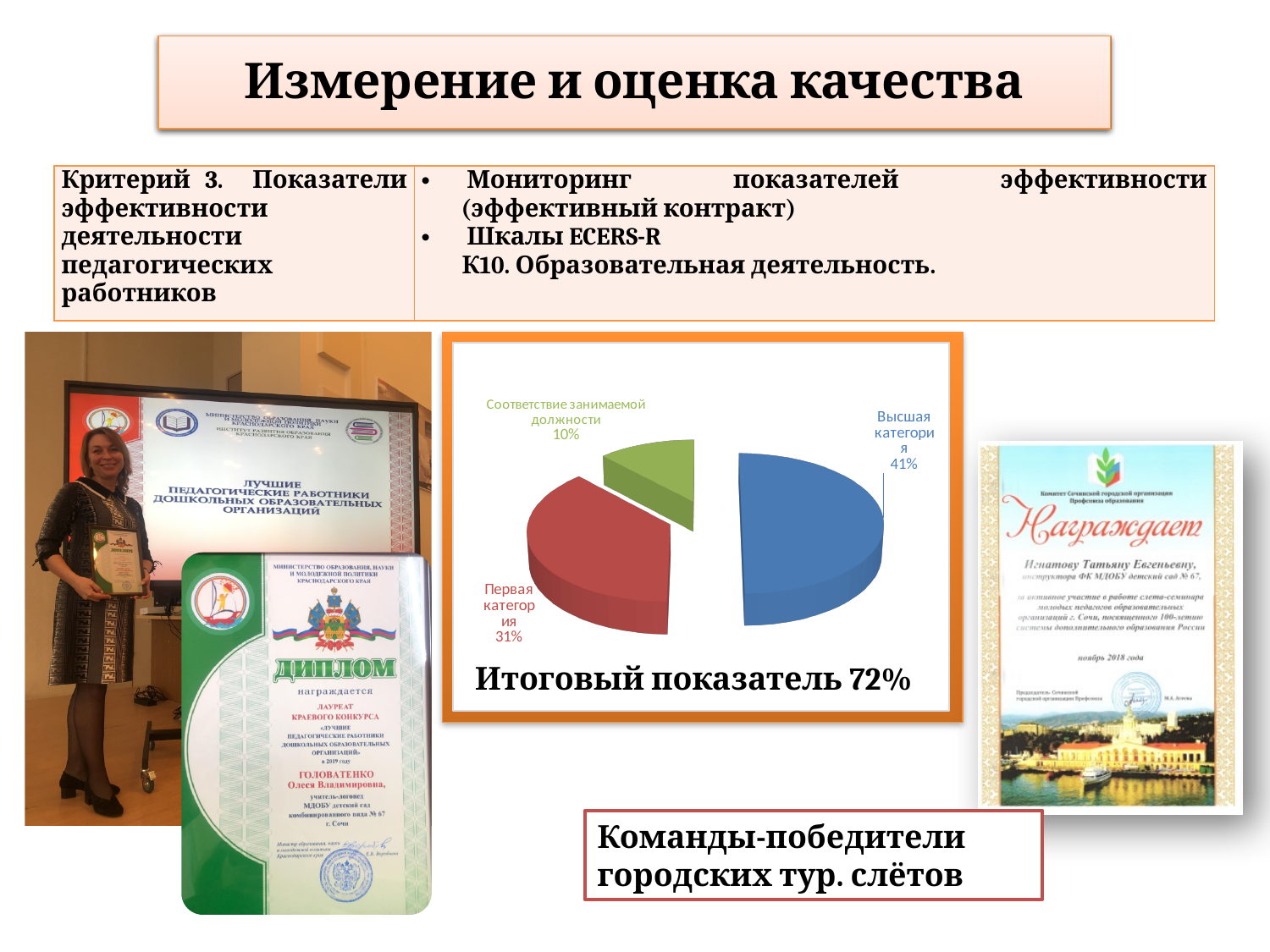
How many slices does the pie chart have? 3 Which is larger: the "Первая категория" slice or the "Соответствие занимаемой должности" slice? Первая категория What share of the pie does the "Первая категория" slice represent? 31% What caption is printed below the pie chart? Итоговый показатель 72% What is the difference in percentage points between the "Высшая категория" and "Первая категория" slices? 10 What share of the pie does the "Соответствие занимаемой должности" slice represent? 10% What kind of chart is shown on the slide? Pie chart What share of the pie does the "Высшая категория" slice represent? 41% What is the difference in percentage points between the "Первая категория" and "Соответствие занимаемой должности" slices? 21 Which slice of the pie chart is the smallest? Соответствие занимаемой должности Which slice of the pie chart is the largest? Высшая категория What colour is the "Высшая категория" slice of the pie chart? Blue